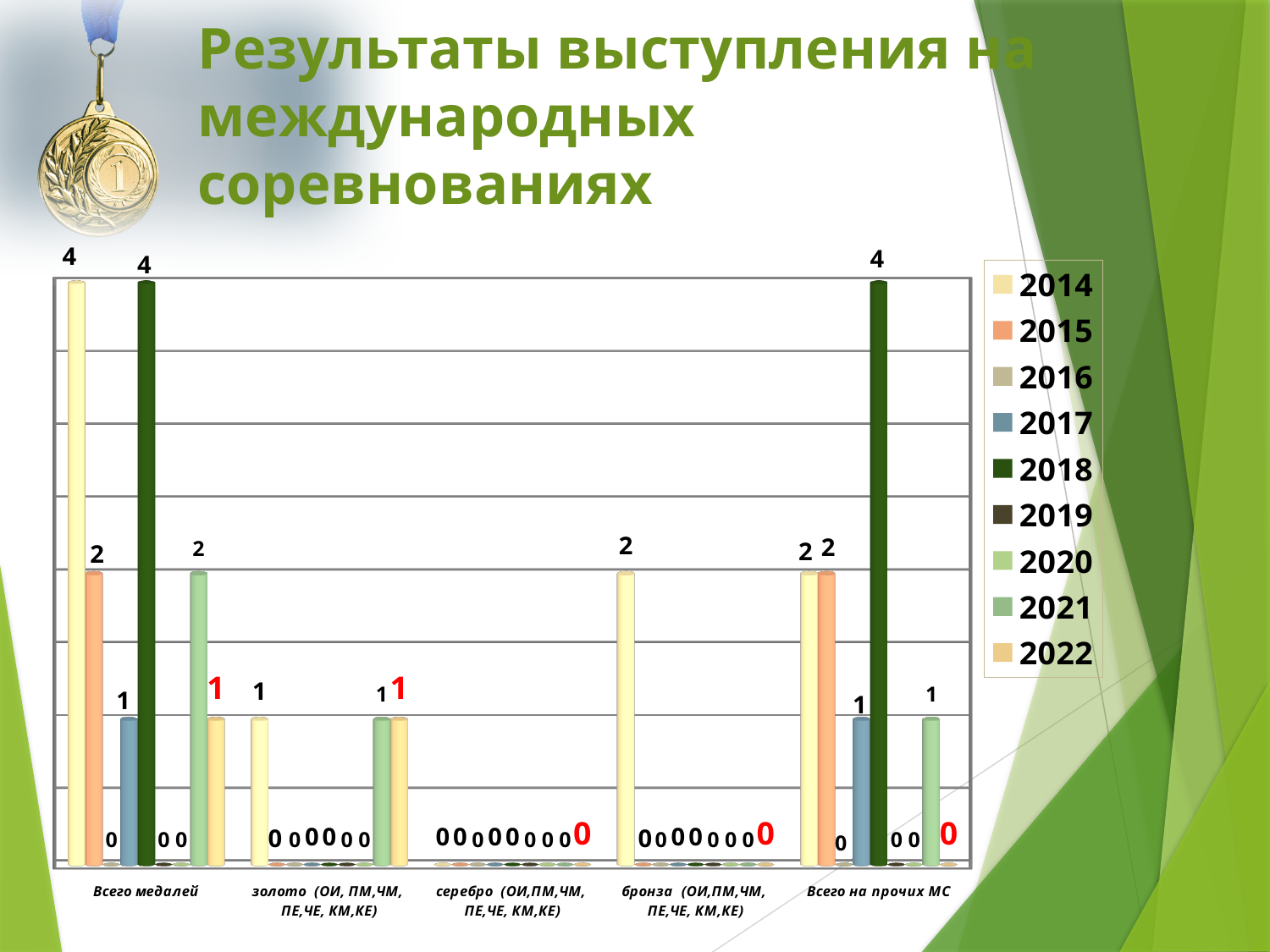
What kind of chart is shown on the slide? Bar chart What is the difference between the 2014 and 2015 values in the "Всего медалей" category? 2 In the "Всего медалей" category, which is larger: the value for 2018 or the value for 2017? 2018 How many series does the legend list? 9 What is the title of the slide containing the chart? Результаты выступления на международных соревнованиях How many categories are shown on the x axis? 5 What is the value for 2022 in the "золото" category? 1 What is the value for 2018 in the "Всего на прочих МС" category? 4 What is the value for 2014 in the "Всего медалей" category? 4 What is the value for 2015 in the "Всего медалей" category? 2 What is the value for 2014 in the "бронза" category? 2 In the "Всего на прочих МС" category, which year has the highest value? 2018